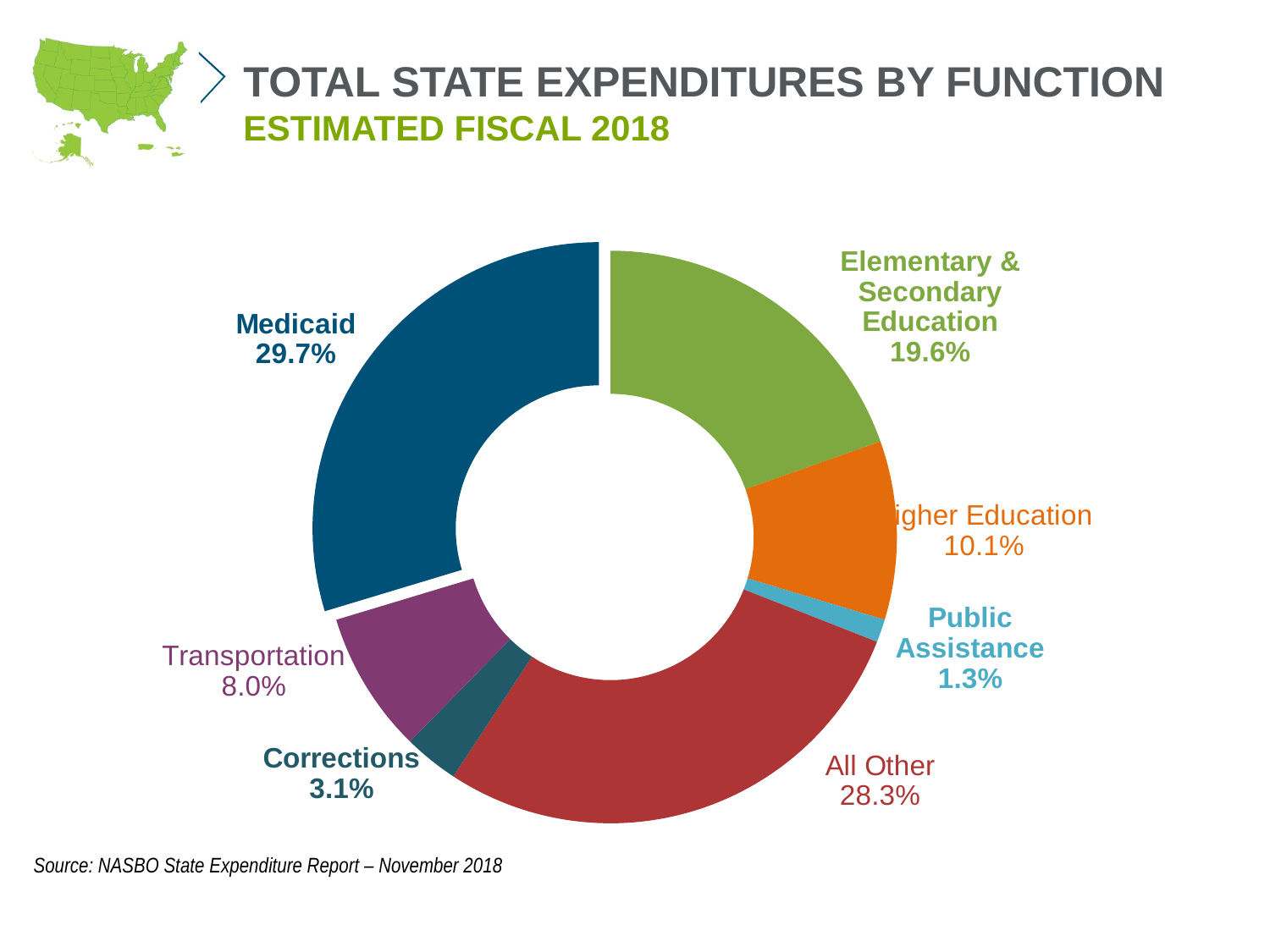
What share of total state expenditures goes to Medicaid? 29.7% What share of total state expenditures goes to Elementary & Secondary Education? 19.6% Which function has the smallest share of total state expenditures? Public Assistance Which function has the largest share of total state expenditures? Medicaid How many functions are shown in the chart? 7 What kind of chart is shown on the slide? Pie chart (doughnut) Which has a larger share, Transportation or Higher Education? Higher Education What share of total state expenditures goes to Higher Education? 10.1% What share of total state expenditures goes to Corrections? 3.1% What share of total state expenditures goes to Public Assistance? 1.3% What is the difference in percentage points between the Medicaid share and the All Other share? 1.4 What fiscal year does the chart cover? Estimated Fiscal 2018